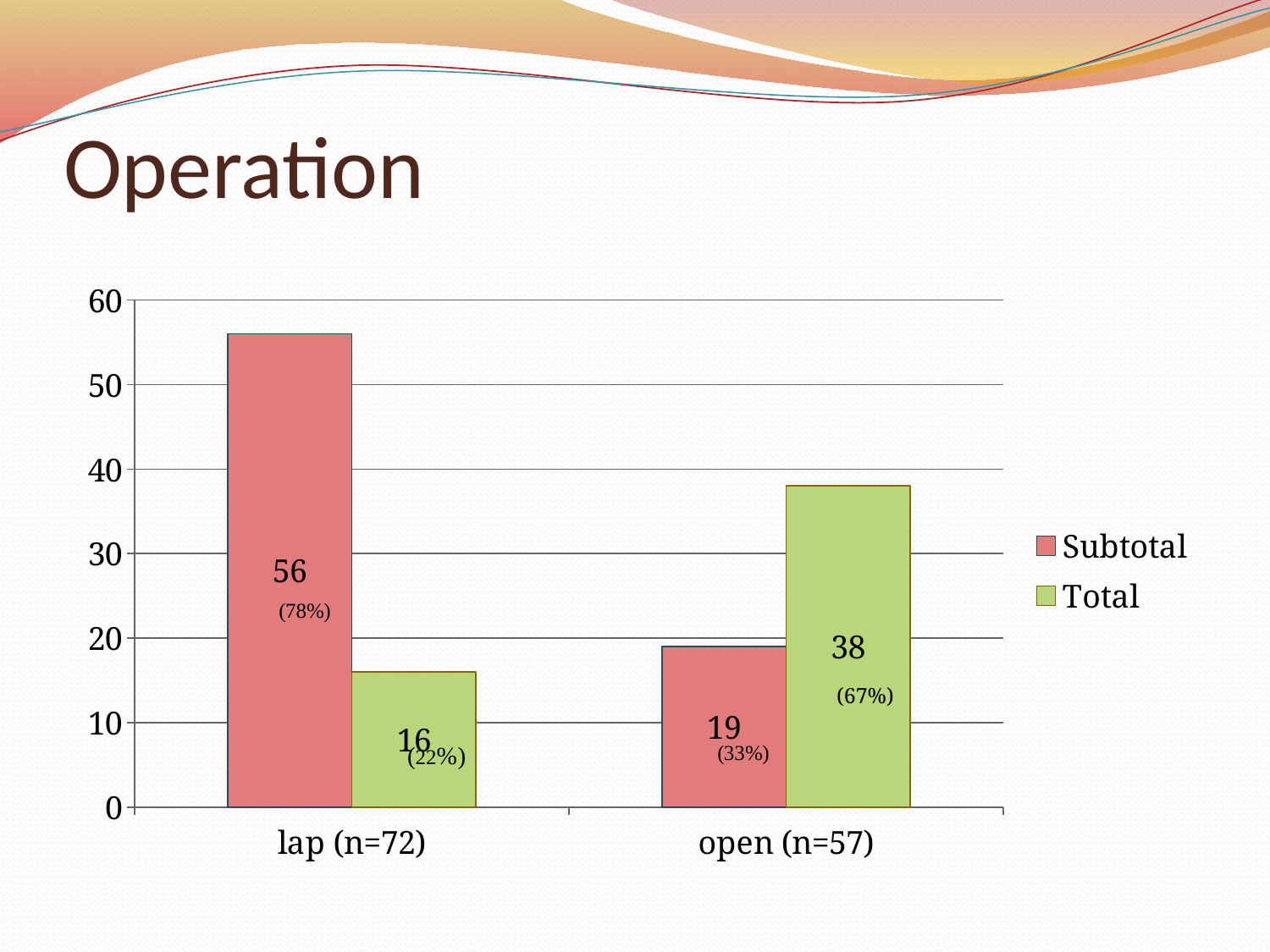
What is the Subtotal value for open (n=57)? 19 How many series does the legend list? 2 What is the difference between the Subtotal and Total values for lap (n=72)? 40 How many categories are shown on the x axis? 2 What is the Total value for lap (n=72)? 16 Is the Total value for open (n=57) greater or less than 40? less What is the Subtotal value for lap (n=72)? 56 What is the Total value for open (n=57)? 38 Which category has the lowest Total value? lap (n=72) Which category has the highest Subtotal value? lap (n=72) What type of chart is shown on the slide? bar chart Which is larger for open (n=57), Subtotal or Total? Total